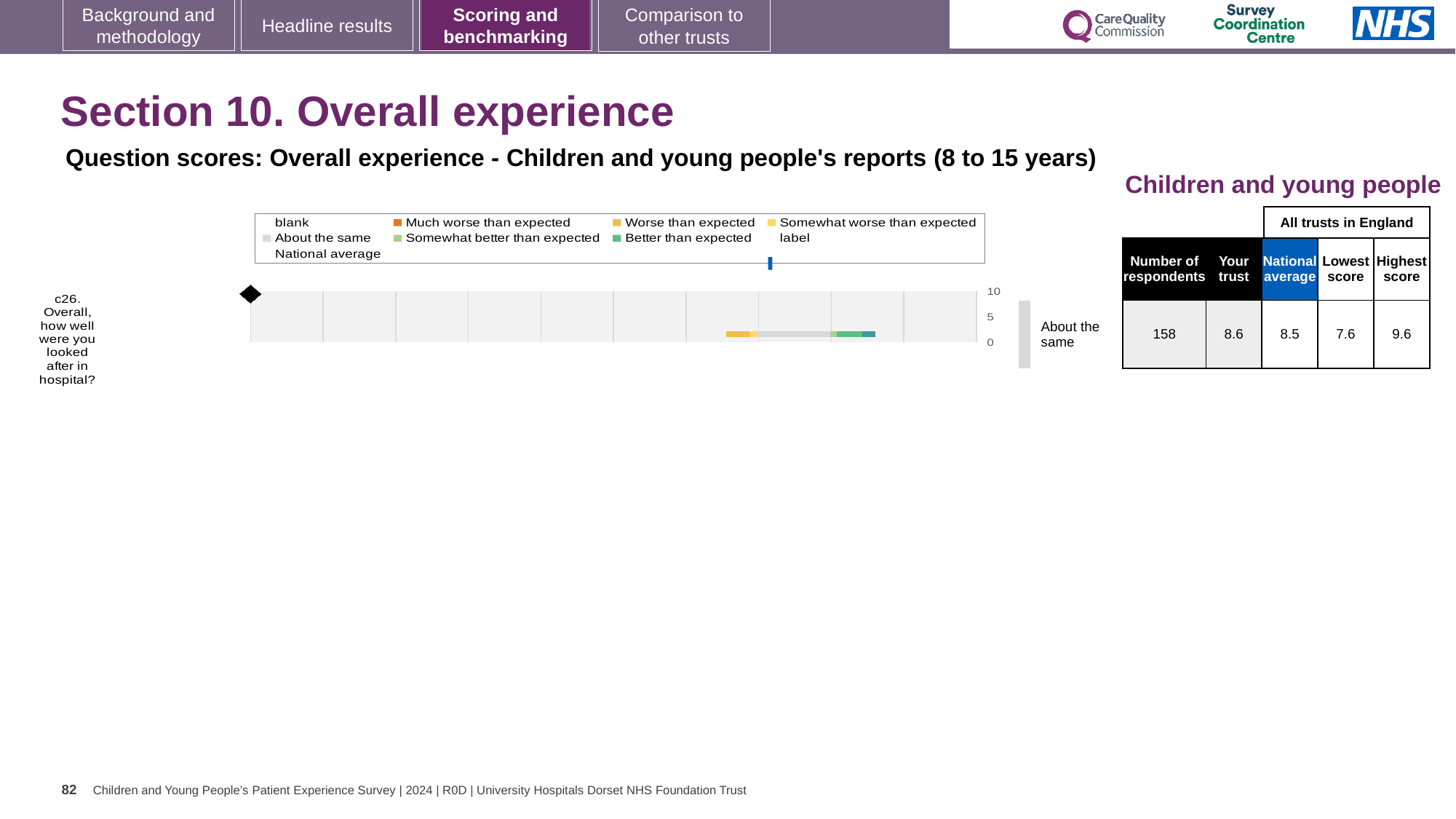
What is the highest value shown on the chart's axis? 10 Which is larger for question c26: the 'Your trust' score or the national average? Your trust What kind of chart is shown on the slide? bar chart How many survey questions are plotted in the chart? 1 How many respondents answered question c26, according to the table beside the chart? 158 According to the table beside the chart, what is the 'Your trust' score for question c26? 8.6 According to the table beside the chart, what is the highest score among all trusts in England for question c26? 9.6 According to the table beside the chart, what is the national average score for question c26? 8.5 What benchmark category is shown next to the bar for question c26? About the same Which question is plotted in the chart? c26. Overall, how well were you looked after in hospital? What is the difference between the highest score and the lowest score for question c26 in the table beside the chart? 2.0 According to the table beside the chart, what is the lowest score among all trusts in England for question c26? 7.6